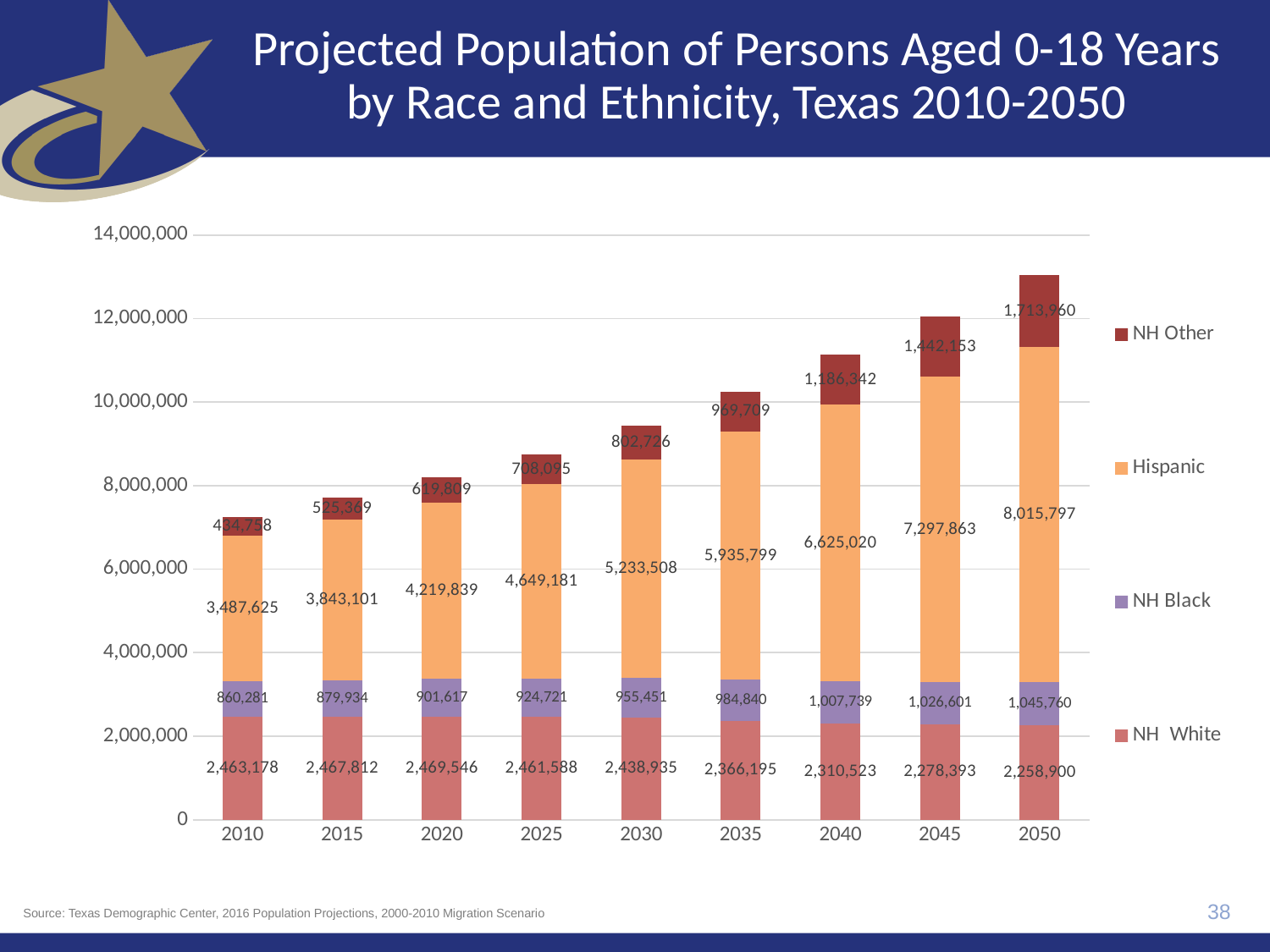
Does the Hispanic value rise or fall from 2010 to 2050? Rise What is the projected NH White population aged 0-18 in 2010? 2,463,178 In which year is the Hispanic value highest? 2050 What is the total projected population aged 0-18 for 2050 (sum of all four groups)? 13,034,417 What is the projected Hispanic population aged 0-18 in 2050? 8,015,797 How many series does the legend list? 4 What is the projected NH Other population aged 0-18 in 2050? 1,713,960 What is the projected NH Black population aged 0-18 in 2030? 955,451 What type of chart is shown on the slide? Stacked bar chart What is the difference between the Hispanic values for 2050 and 2010? 4,528,172 In which year is the NH White value lowest? 2050 How many years are shown along the x axis? 9